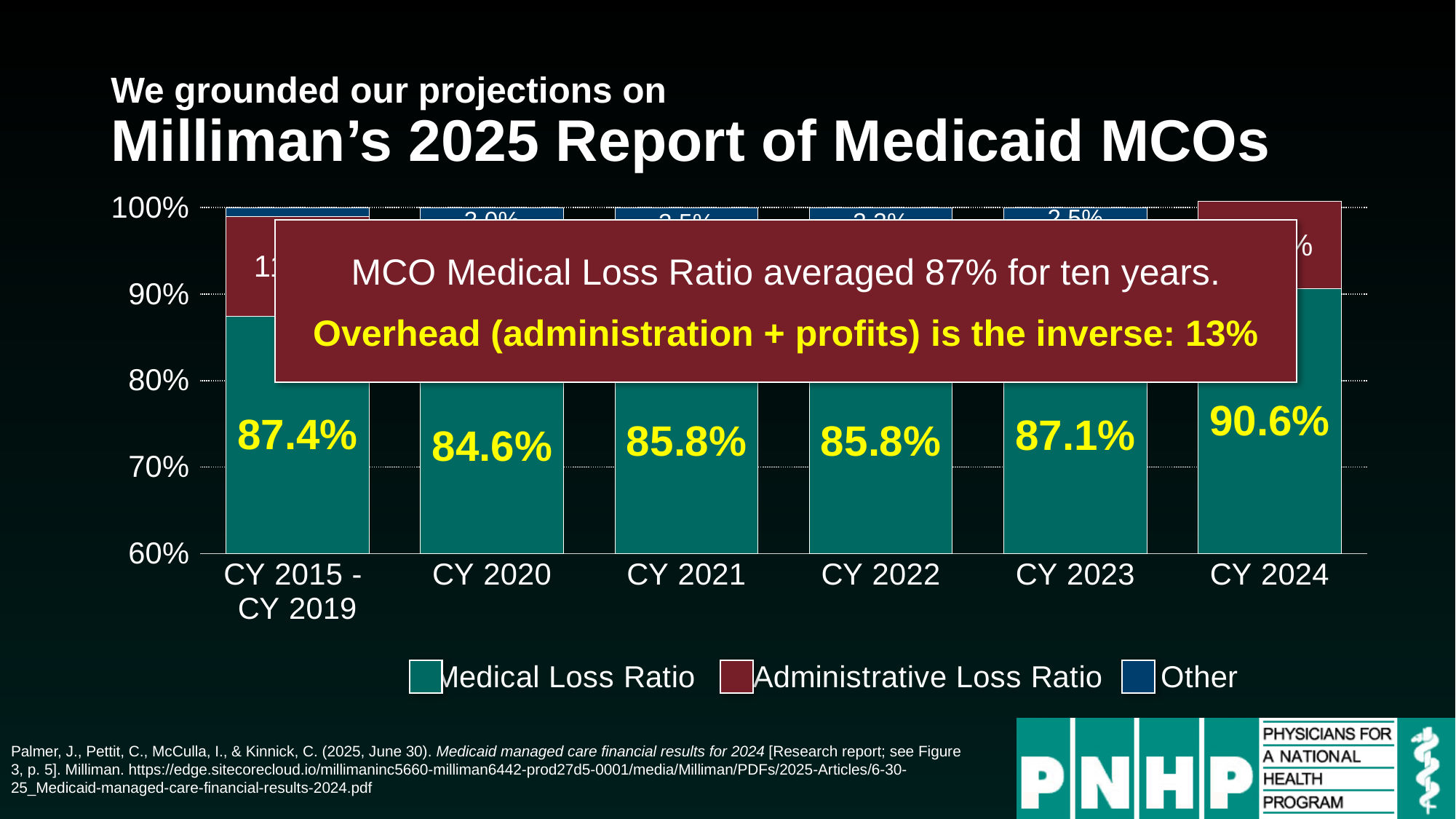
What is the Medical Loss Ratio for CY 2020? 84.6% How many periods are shown on the x axis? 6 Which period has the lowest Medical Loss Ratio? CY 2020 What is the Medical Loss Ratio for CY 2024? 90.6% What is the Medical Loss Ratio for CY 2023? 87.1% Which period has the highest Medical Loss Ratio? CY 2024 What kind of chart is shown on the slide? Stacked bar chart What is the Medical Loss Ratio for CY 2015 - CY 2019? 87.4% Does the Medical Loss Ratio rise or fall from CY 2020 to CY 2024? Rise Which has a higher Medical Loss Ratio, CY 2021 or CY 2023? CY 2023 What is the difference between the Medical Loss Ratio for CY 2024 and CY 2020? 6.0% How many series does the legend list? 3